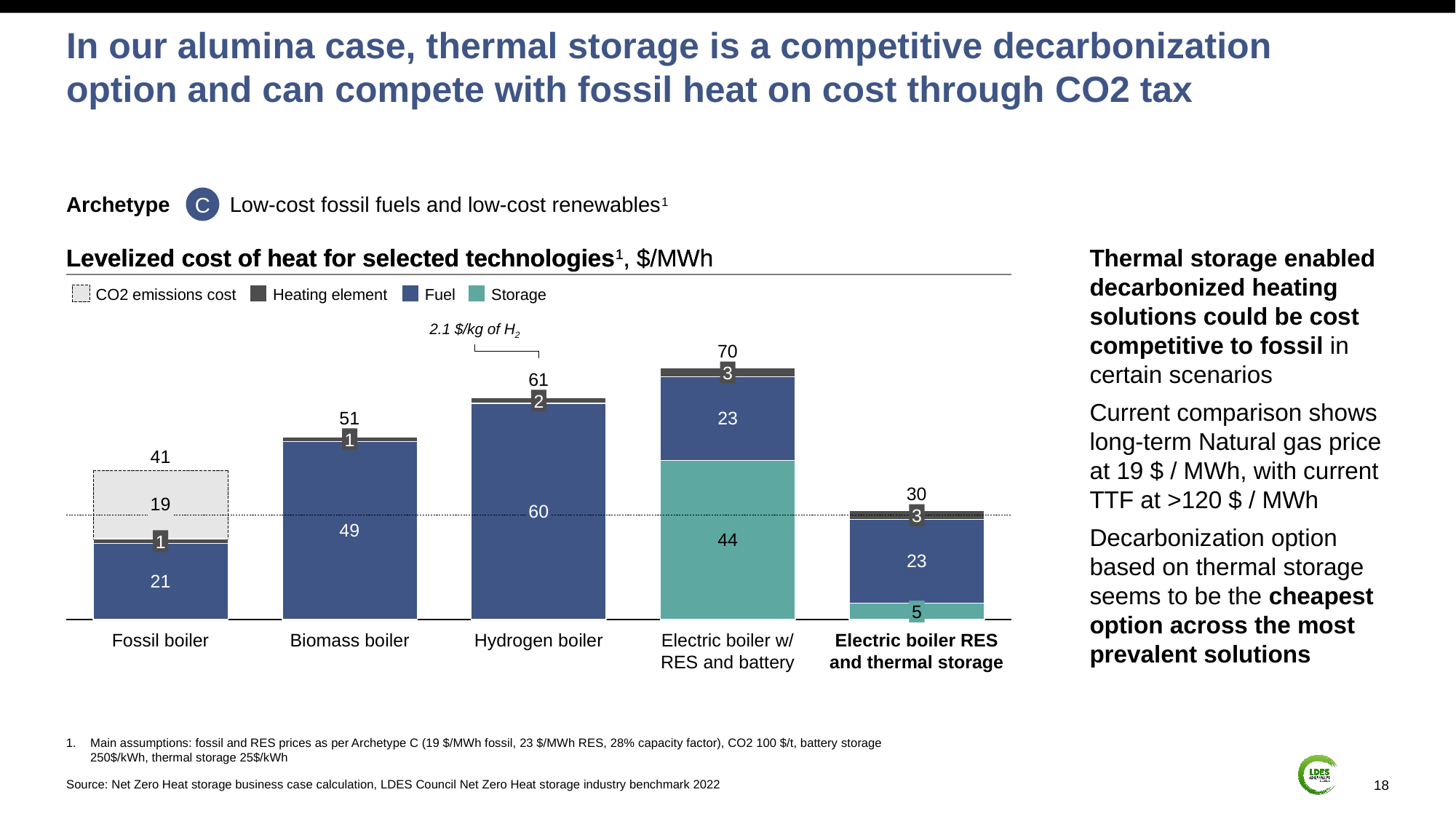
What is the total levelized cost of heat for the Hydrogen boiler? 61 How many technologies are shown on the x axis of the chart? 5 What is the CO2 emissions cost component for the Fossil boiler? 19 Which has a larger total levelized cost of heat, the Biomass boiler or the Hydrogen boiler? Hydrogen boiler What kind of chart is used to show the levelized cost of heat? Stacked bar chart What hydrogen price is annotated above the Hydrogen boiler bar? 2.1 $/kg of H2 What is the difference between the total cost of the Fossil boiler and the Electric boiler RES and thermal storage? 11 Which technology has the highest total levelized cost of heat? Electric boiler w/ RES and battery How many series does the chart legend list? 4 What is the Fuel cost component for the Biomass boiler? 49 Which technology has the lowest total levelized cost of heat? Electric boiler RES and thermal storage What is the Storage cost component for the Electric boiler w/ RES and battery? 44